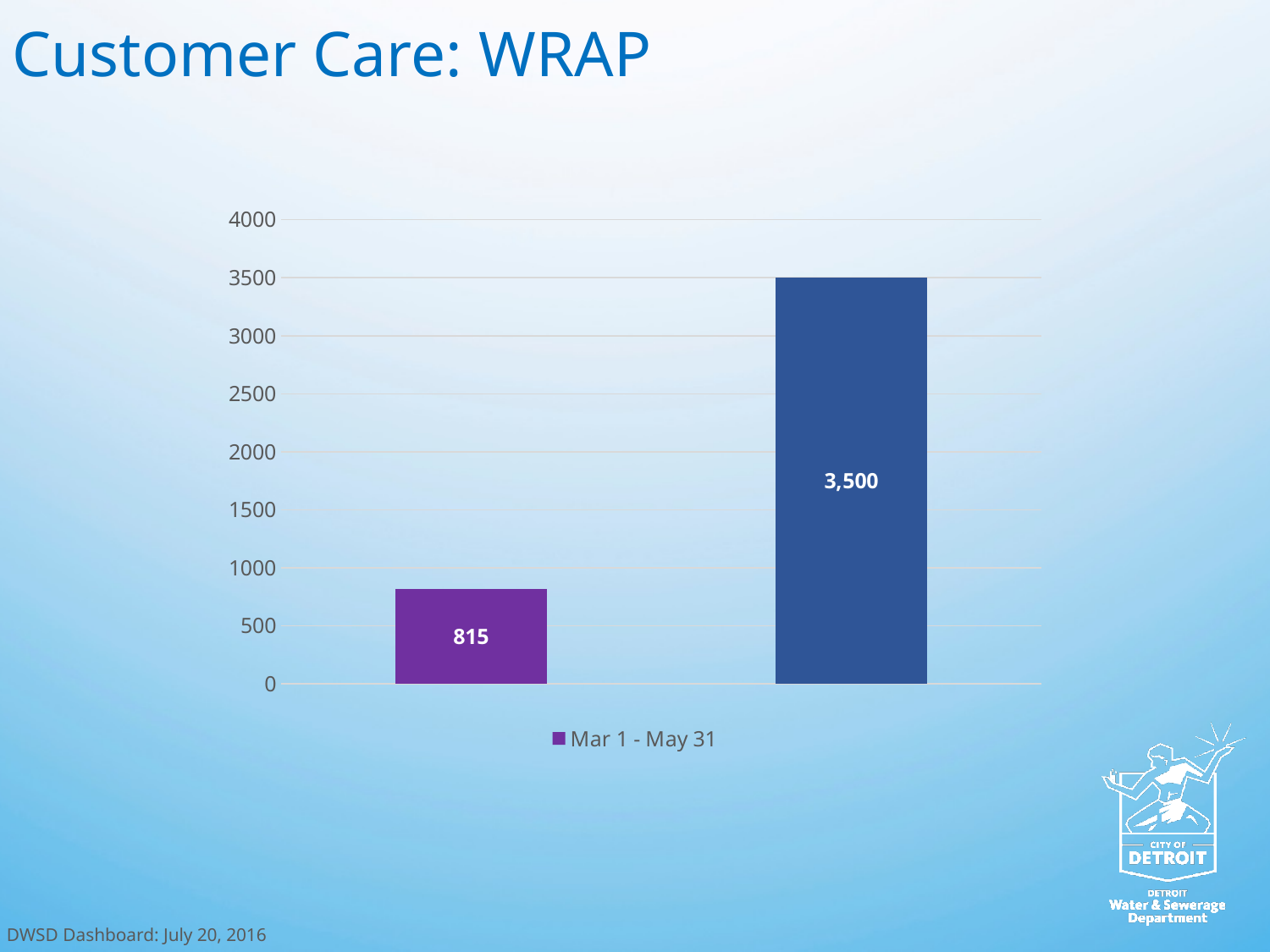
What date range does the legend entry show? Mar 1 - May 31 Which bar has the higher value, the left purple bar or the right blue bar? the right blue bar What is the difference between the two bar values, 3,500 and 815? 2,685 What is the value shown on the purple bar on the left? 815 How many entries does the legend list? 1 What is the lowest value shown in the chart? 815 Is the value of the left purple bar greater or less than 1000? less What is the highest value shown in the chart? 3,500 What is the value shown on the blue bar on the right? 3,500 What type of chart is shown on the slide? bar chart How many bars are plotted in the chart? 2 Is the value of the right blue bar greater or less than 3000? greater